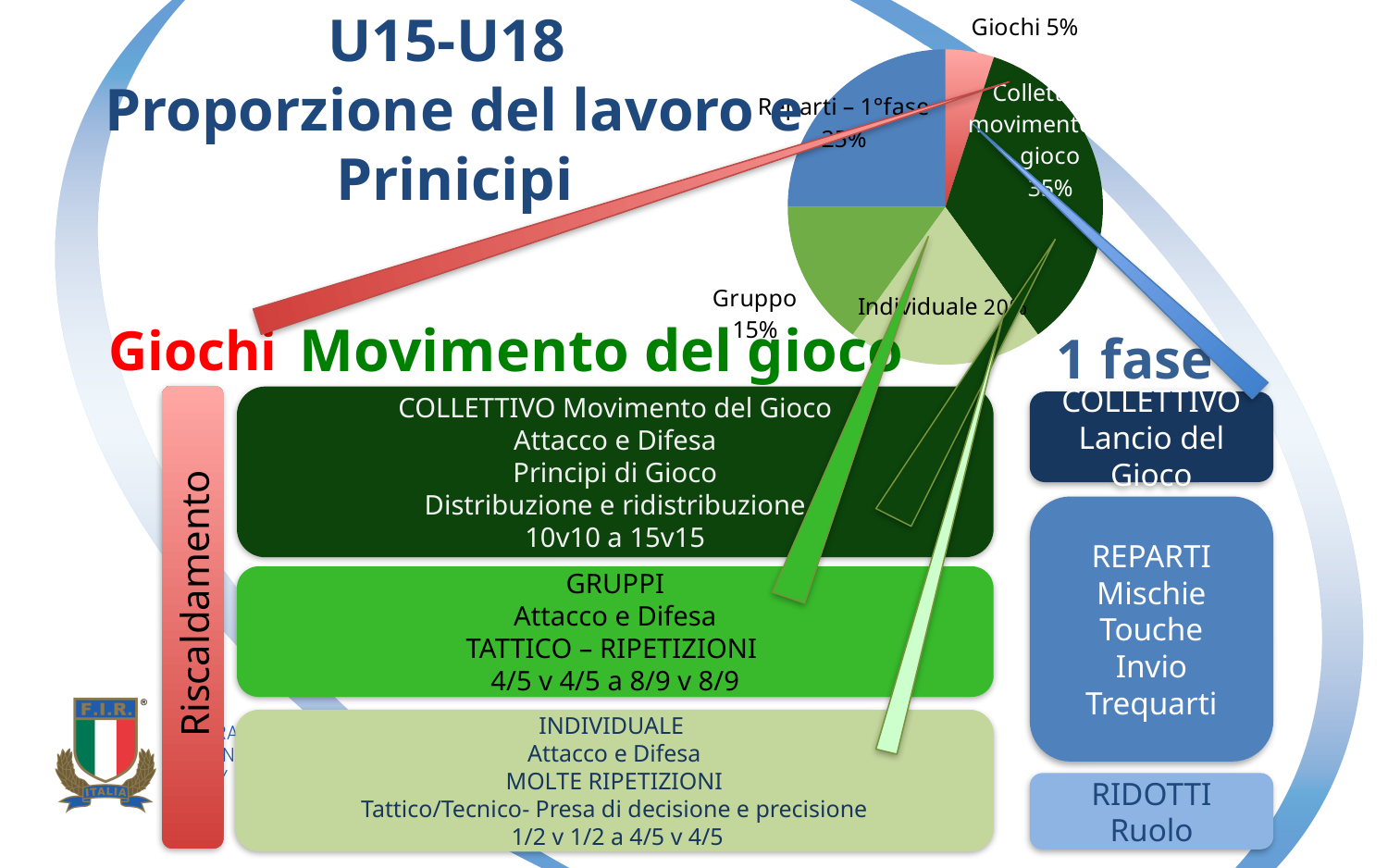
What percentage of the pie chart is labelled Giochi? 5% What percentage of the pie chart is labelled Gruppo? 15% How many slices does the pie chart have? 5 What colour is the Giochi slice in the pie chart? red What percentage of the pie chart is labelled Reparti – 1°fase? 25% Which slice of the pie chart is the smallest? Giochi Which slice is larger in the pie chart, Individuale or Gruppo? Individuale Which slice of the pie chart is the largest? Collettivo movimento gioco Which slice is larger in the pie chart, Reparti – 1°fase or Giochi? Reparti – 1°fase What percentage of the pie chart is labelled Individuale? 20% What is the difference in percentage points between the Individuale slice and the Gruppo slice? 5 What type of chart is shown on the slide? pie chart